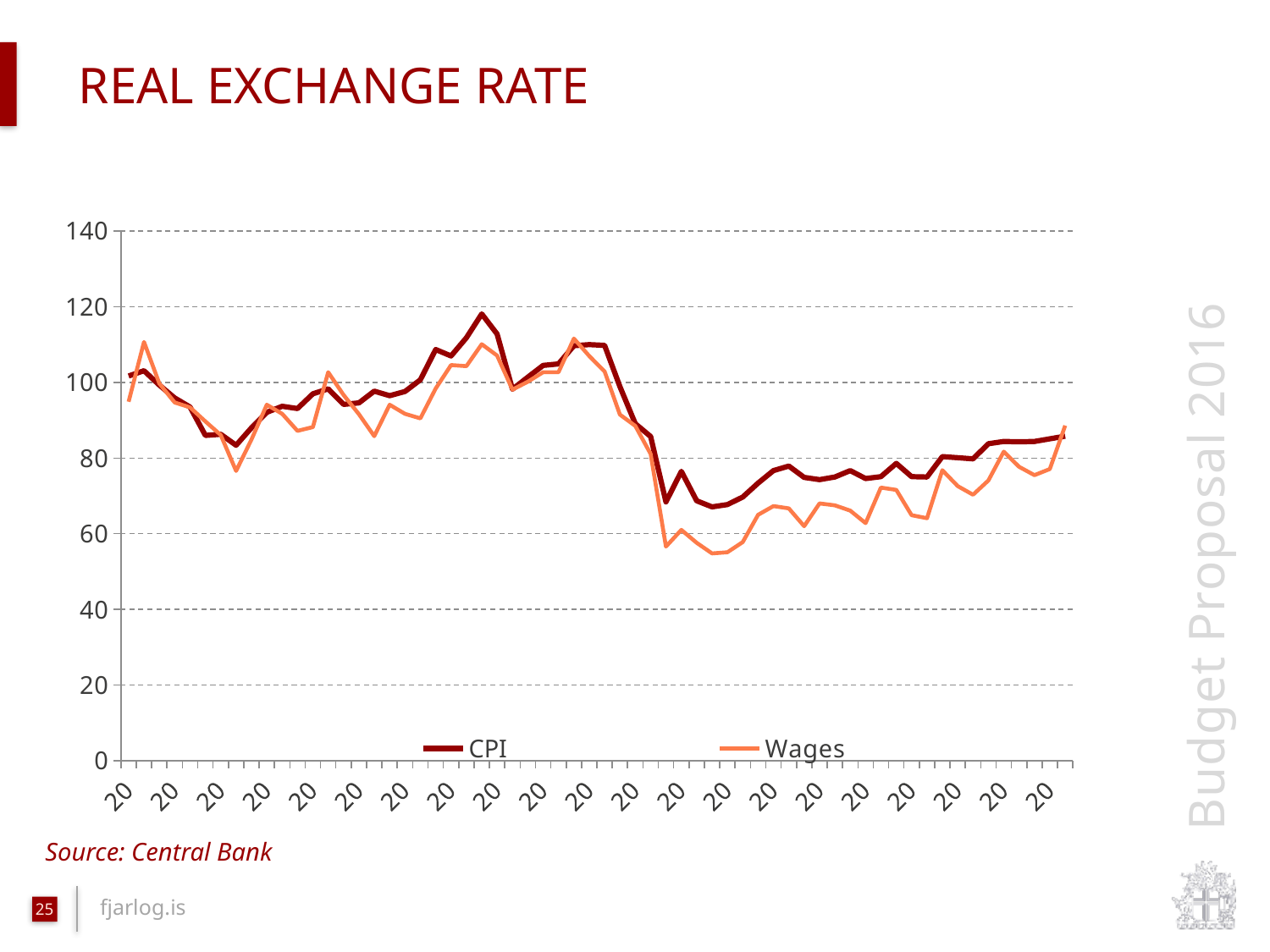
Is the lowest value of the Wages line greater or less than 60? less In the second half of the chart, which series is generally higher, CPI or Wages? CPI Which series reaches the highest peak on the chart? CPI Is the lowest value of the CPI line greater or less than 60? greater Over the whole period, is the CPI line higher at the start or at the end of the x axis? At the start What kind of chart is shown on the slide? Line chart Is the final value of the Wages line greater or less than 80? greater What are the two series named in the legend? CPI and Wages What is the title of the chart? REAL EXCHANGE RATE Which series falls to the lowest point on the chart? Wages How many series does the legend list? 2